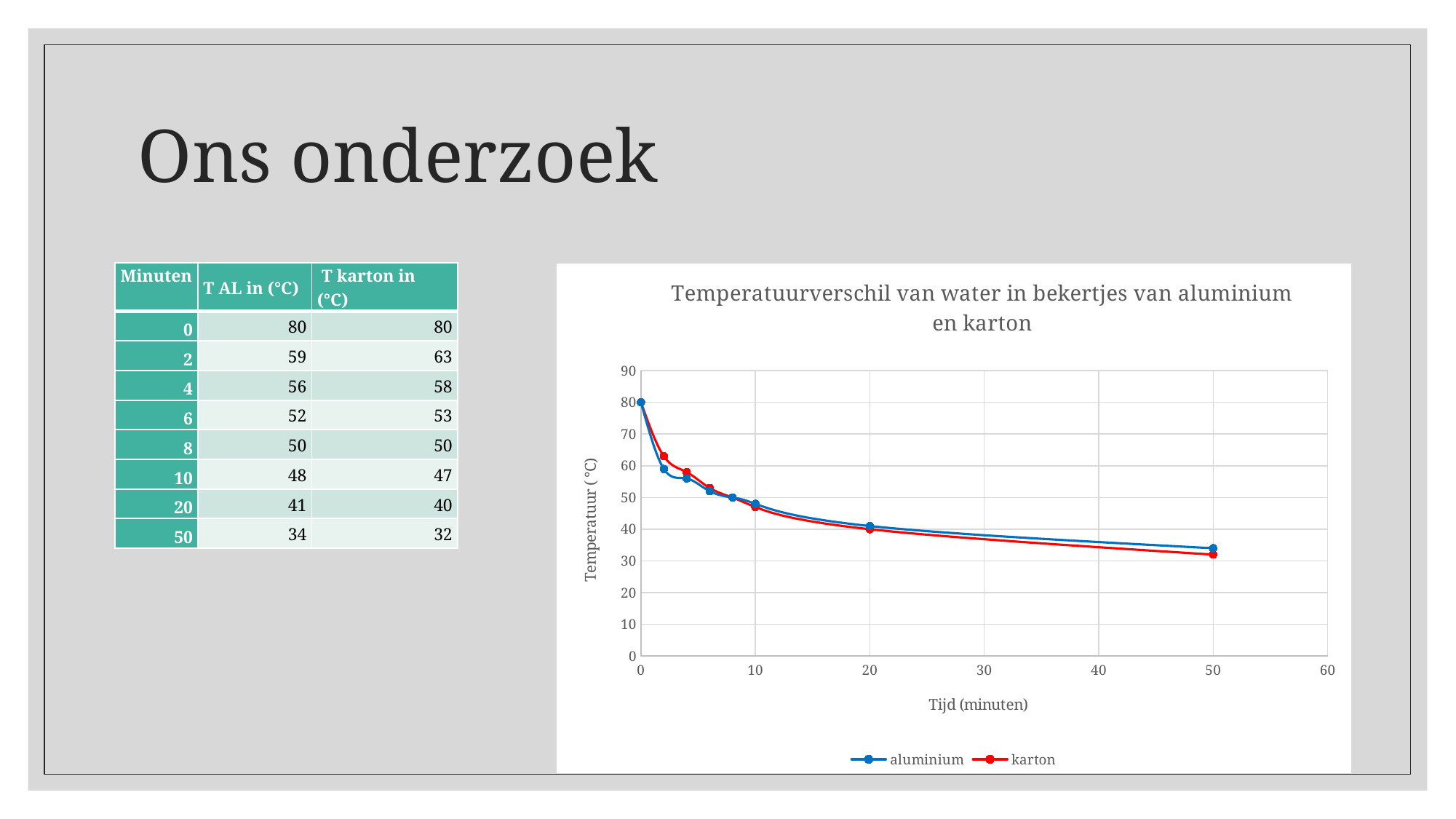
Is the value for aluminium at 50 minutes greater or less than 40? less Do the temperatures rise or fall as time increases along the x axis? fall What is the difference between the aluminium and karton temperatures at 2 minutes? 4 Is the value for karton at 2 minutes greater or less than 60? greater What is the temperature of the karton series at 50 minutes? 32 How many series does the chart legend list? 2 What kind of chart is shown on the slide? line chart How many data points does each series have? 8 What is the label of the x axis of the chart? Tijd (minuten) What is the temperature of the aluminium series at 0 minutes? 80 What is the title of the chart? Temperatuurverschil van water in bekertjes van aluminium en karton What is the temperature of the aluminium series at 20 minutes? 41